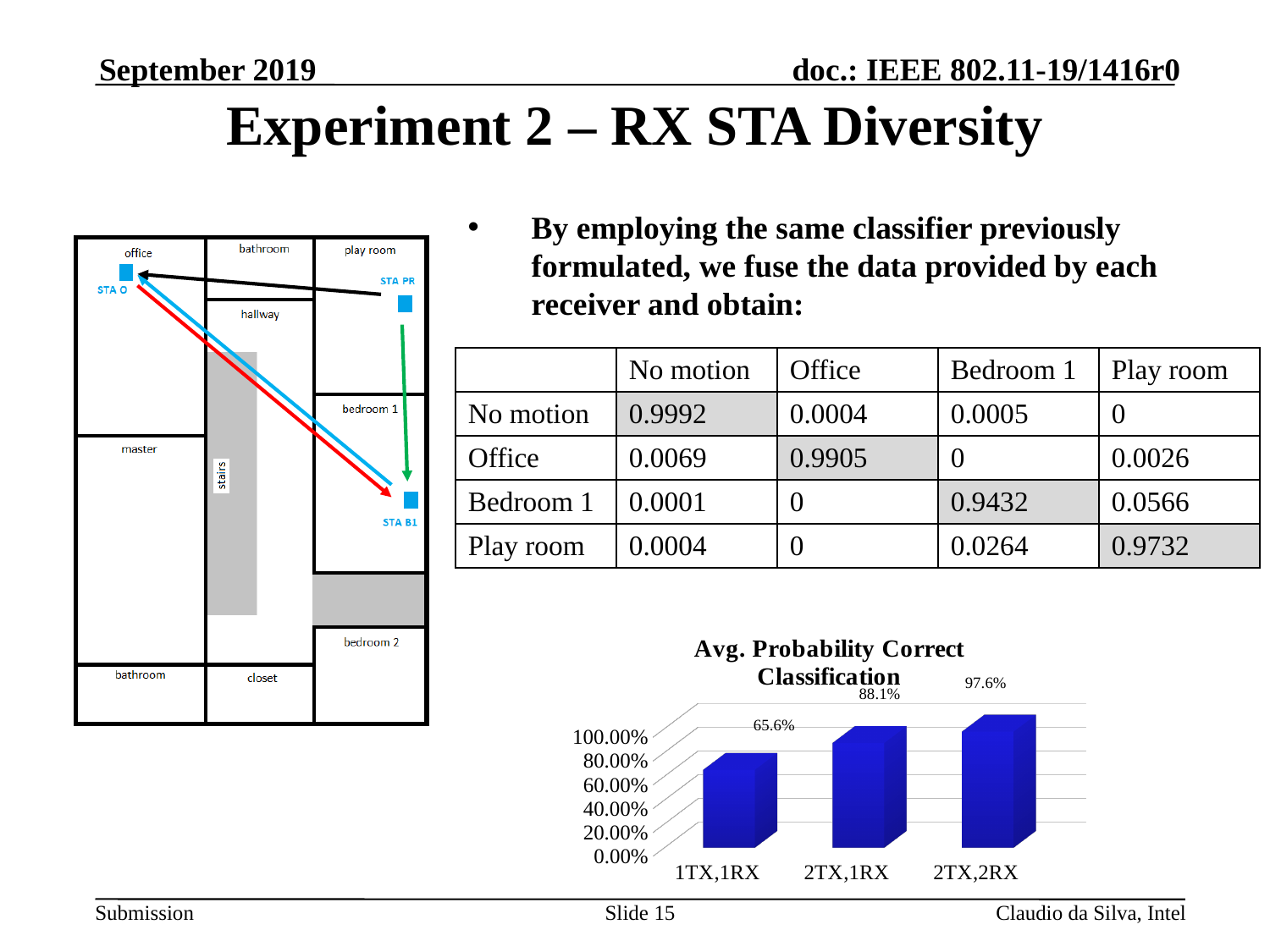
Is the value for 1TX,1RX in the Avg. Probability Correct Classification chart greater or less than 80.00%? less What is the value for 2TX,2RX in the Avg. Probability Correct Classification chart? 97.6% Do the values in the Avg. Probability Correct Classification chart rise or fall from 1TX,1RX to 2TX,2RX? rise Which category has the lowest value in the Avg. Probability Correct Classification chart? 1TX,1RX Which is larger in the Avg. Probability Correct Classification chart, the value for 2TX,1RX or 1TX,1RX? 2TX,1RX What is the difference between the values for 2TX,1RX and 1TX,1RX in the Avg. Probability Correct Classification chart? 22.5% What is the value for 2TX,1RX in the Avg. Probability Correct Classification chart? 88.1% How many categories are shown in the Avg. Probability Correct Classification chart? 3 Which category has the highest value in the Avg. Probability Correct Classification chart? 2TX,2RX What is the value for 1TX,1RX in the Avg. Probability Correct Classification chart? 65.6% What kind of chart is the Avg. Probability Correct Classification chart? bar chart What is the difference between the values for 2TX,2RX and 2TX,1RX in the Avg. Probability Correct Classification chart? 9.5%